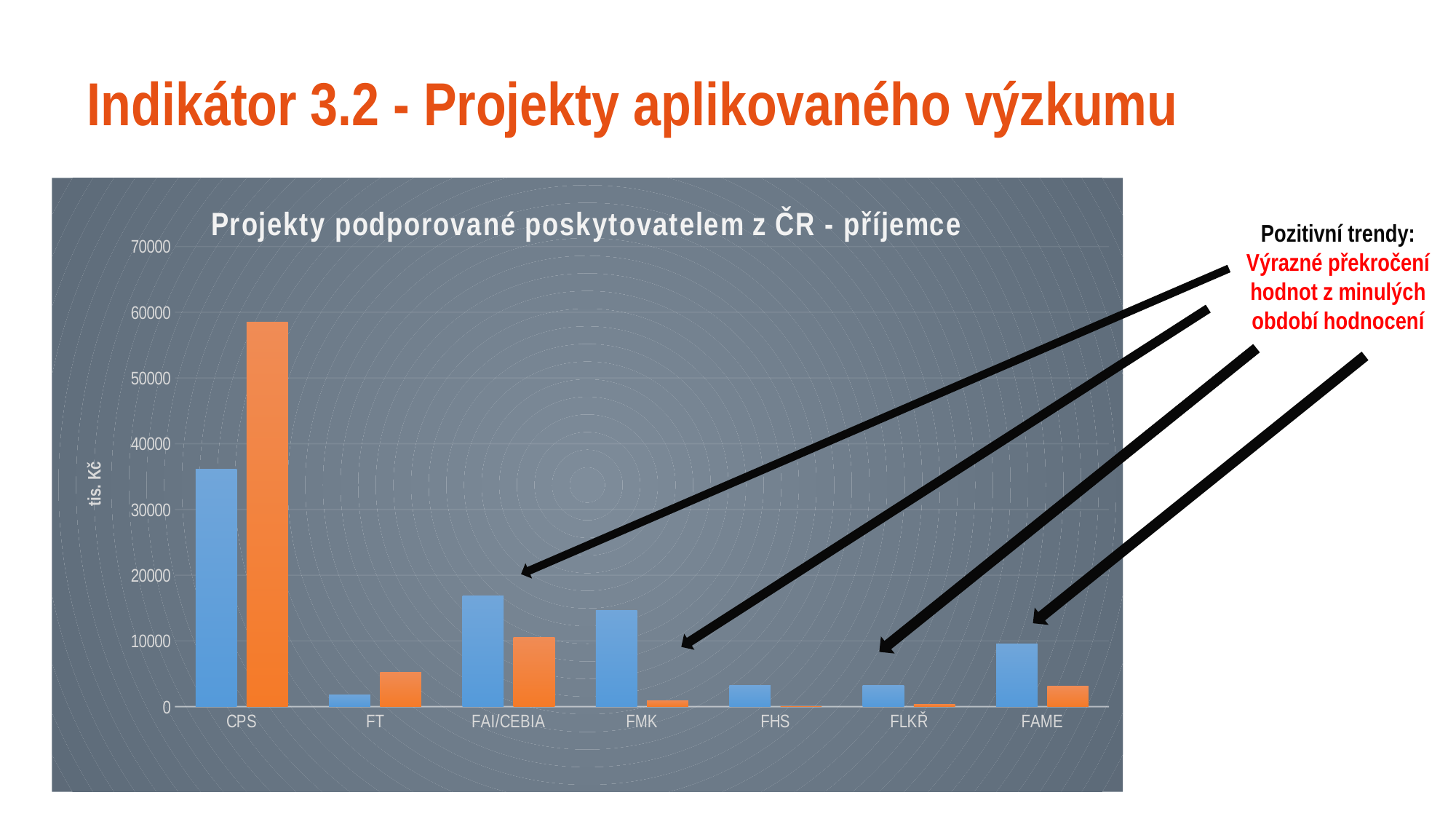
Is the blue bar for CPS greater or less than 30000? greater What kind of chart is shown on the slide? bar chart What is the title of the chart? Projekty podporované poskytovatelem z ČR - příjemce For CPS, which bar is taller, the blue one or the orange one? the orange one For FAI/CEBIA, which bar is taller, the blue one or the orange one? the blue one Which category has the tallest bar in the chart? CPS Is the blue bar for FMK greater or less than 10000? greater How many categories are shown on the x axis of the chart? 7 Is the orange bar for CPS greater or less than 50000? greater Which category has the tallest blue bar? CPS Which category has the shortest blue bar? FT What is the label on the vertical axis of the chart? tis. Kč